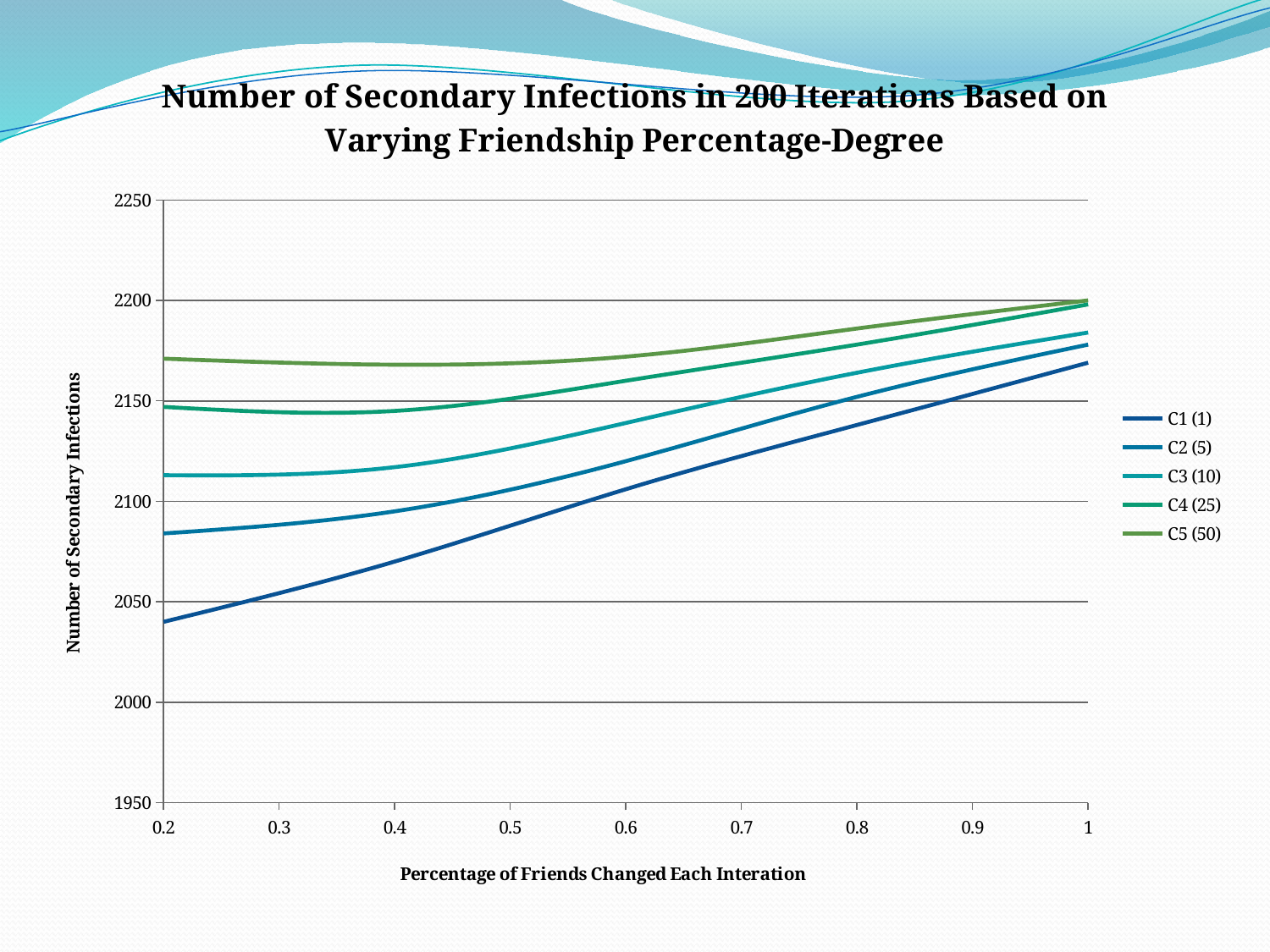
Is the value for C5 (50) at 0.2 greater or less than 2150? greater Which series has the highest number of secondary infections at 0.2 on the x axis? C5 (50) At 0.2 on the x axis, which is larger: the value for C5 (50) or the value for C1 (1)? C5 (50) What is the title of the y axis? Number of Secondary Infections Which series has the lowest number of secondary infections at 0.2 on the x axis? C1 (1) How many series does the legend list? 5 Is the value for C2 (5) at 0.2 greater or less than 2100? less Is the value for C1 (1) at 0.2 greater or less than 2050? less What kind of chart is shown on the slide? line chart Does the C1 (1) line rise or fall as the percentage of friends changed increases from 0.2 to 1? rise What is the title of the x axis? Percentage of Friends Changed Each Interation